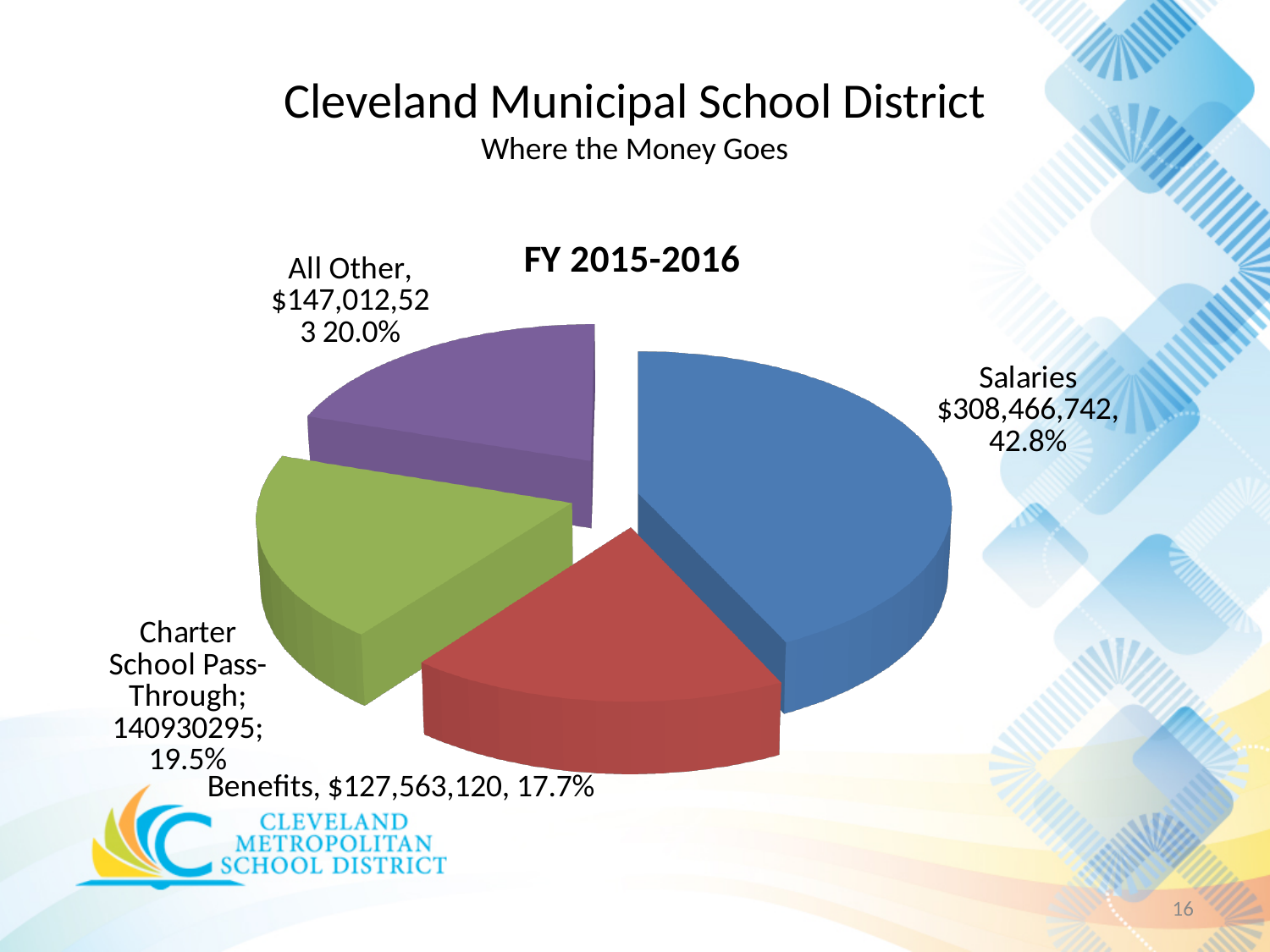
Which is larger, the Salaries slice or the Benefits slice? Salaries What is the title of the chart? FY 2015-2016 What percentage share is shown for Charter School Pass-Through? 19.5% What is the dollar value shown for Salaries? $308,466,742 Which category has the smallest share of the pie? Benefits What percentage share is shown for All Other? 20.0% What percentage of the pie does Benefits represent? 17.7% How many slices does the pie chart have? 4 Which category has the largest share of the pie? Salaries What type of chart is shown on the slide? Pie chart What is the dollar value shown for Benefits? $127,563,120 What is the difference in percentage points between the Salaries share and the Benefits share? 25.1 percentage points